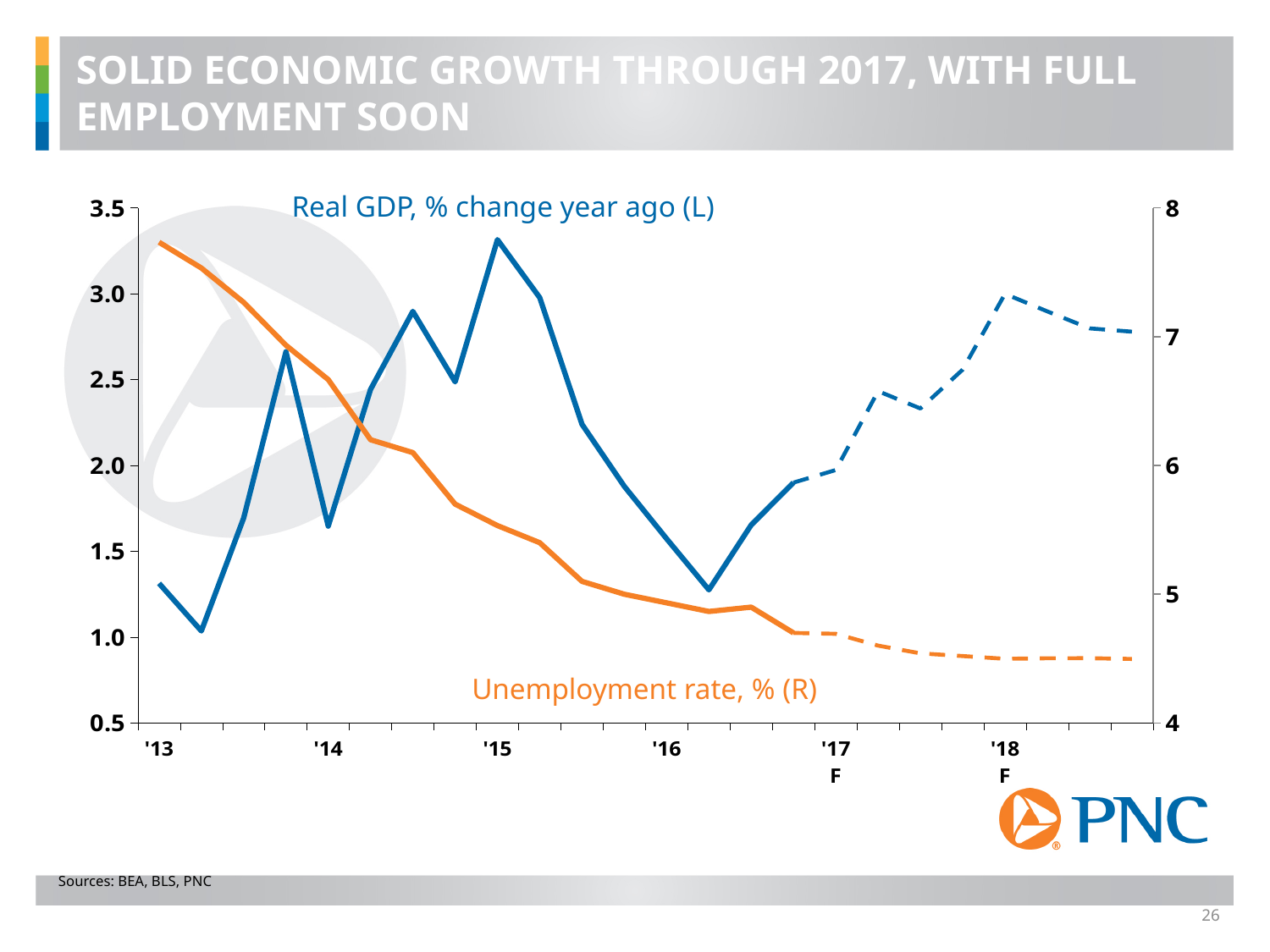
Does the Real GDP line rise or fall from '16 to '18? rise How many data series are plotted on the chart? 2 Is the unemployment rate higher at '13 or at '17? '13 How many year labels appear on the x axis? 6 Is the unemployment rate at the start of '13 greater or less than 7? greater Is the peak value of Real GDP around '15 greater or less than 3.0? greater Is the unemployment rate at '18 greater or less than 5? less What colour is the Real GDP line? blue Which axis, left or right, is used for the unemployment rate series? right Does the unemployment rate rise or fall from '13 to '18? fall What kind of chart is shown on the slide? line chart